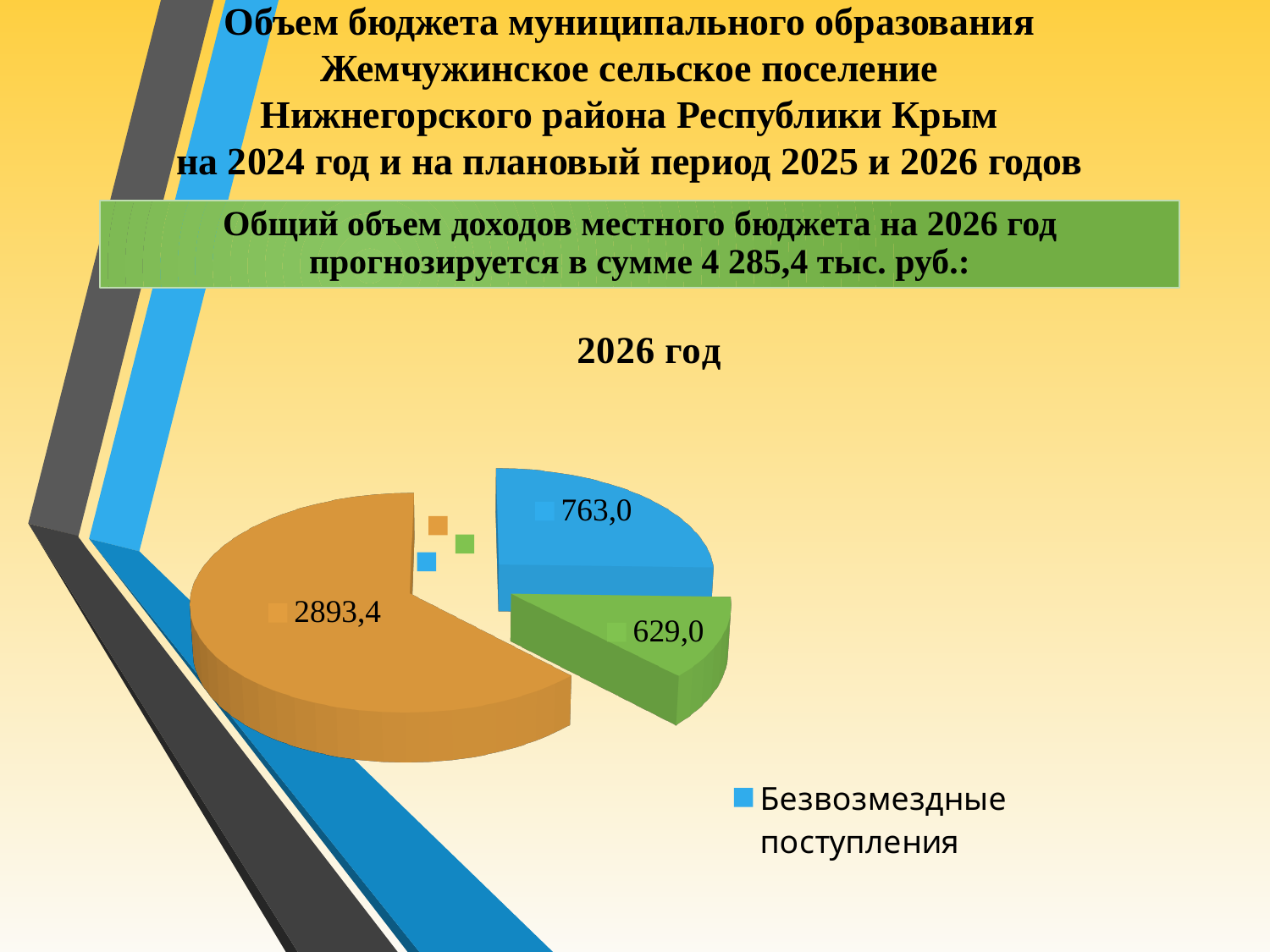
What kind of chart is shown on the slide? pie chart How many slices does the pie chart have? 3 What is the title of the pie chart? 2026 год What value is labelled on the orange slice of the pie chart? 2893,4 What is the difference between the orange slice (2893,4) and the Безвозмездные поступления slice (763,0)? 2130,4 Which is larger in the pie chart: the Безвозмездные поступления slice or the green slice? Безвозмездные поступления What value is labelled on the green slice of the pie chart? 629,0 What is the total of all three slices in the pie chart? 4 285,4 Which slice of the pie chart has the largest value? the orange slice (2893,4) Which slice of the pie chart has the smallest value? the green slice (629,0) What is the difference between the Безвозмездные поступления slice (763,0) and the green slice (629,0)? 134,0 What value is shown for Безвозмездные поступления in the pie chart? 763,0